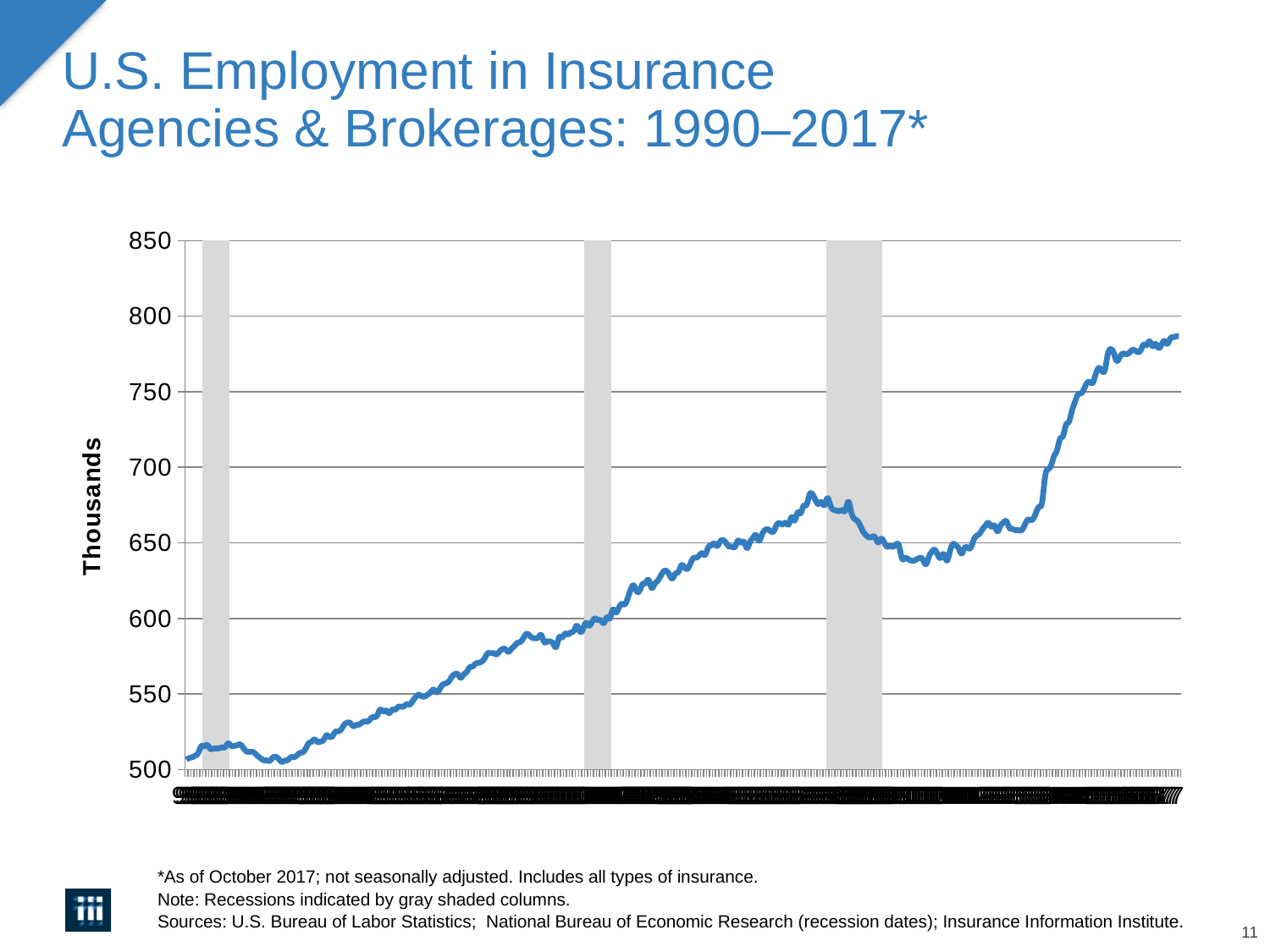
Overall, does the plotted line rise or fall from the left end of the chart to the right end? Rise How many lines are plotted on the chart? 1 Which is larger: the value at the right end of the line or the value at the left end of the line? The right end What is the title of the chart on the slide? U.S. Employment in Insurance Agencies & Brokerages: 1990–2017* What kind of chart is shown on the slide? Line chart Is the value at the right end of the line (the most recent point) greater or less than 750? greater Is the lowest point of the line after the third gray shaded column greater or less than 600? greater Is the value at the left end of the line (the earliest point) greater or less than 550? less What is the label on the vertical axis of the chart? Thousands How many gray shaded recession columns appear on the chart? 3 What is the highest value shown on the vertical axis of the chart? 850